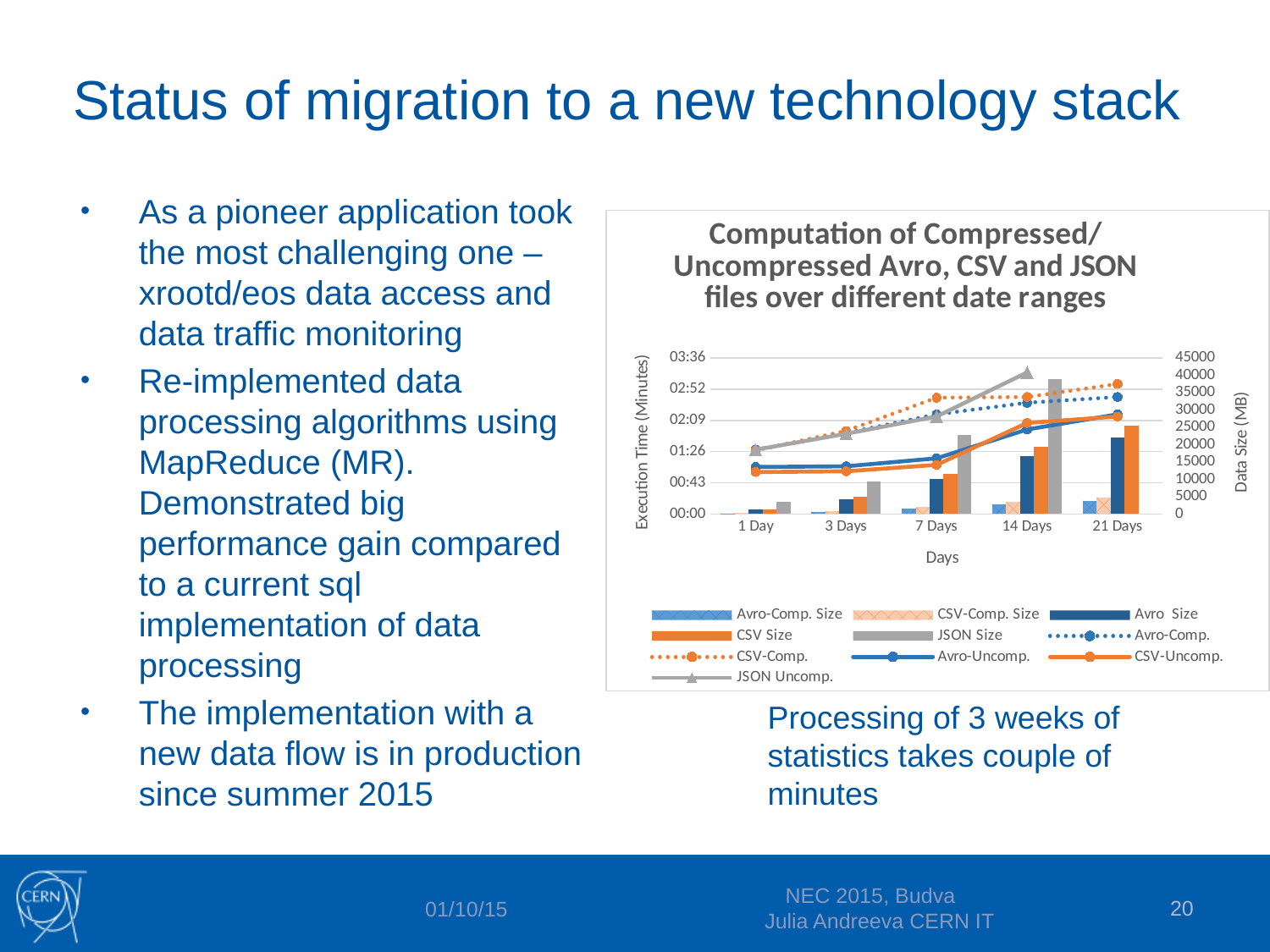
Is the JSON Size value for 14 Days greater or less than 35000? greater What is the label of the right-hand vertical axis of the chart? Data Size (MB) What kind of chart is shown on the slide? A combined bar and line chart What is the title of the chart? Computation of Compressed/Uncompressed Avro, CSV and JSON files over different date ranges Is the CSV Size value for 21 Days greater or less than 20000? greater Is the Avro-Comp. Size value for 21 Days greater or less than 5000? less How many series does the chart's legend list? 10 How many date-range categories are shown on the x axis of the chart? 5 Do the Avro Size bars rise or fall as the date range increases from 1 Day to 21 Days? rise At 21 Days, which is larger: the CSV Size bar or the Avro Size bar? CSV Size For which date range is the JSON Size bar the tallest? 14 Days At 14 Days, which is larger: the JSON Size bar or the CSV Size bar? JSON Size